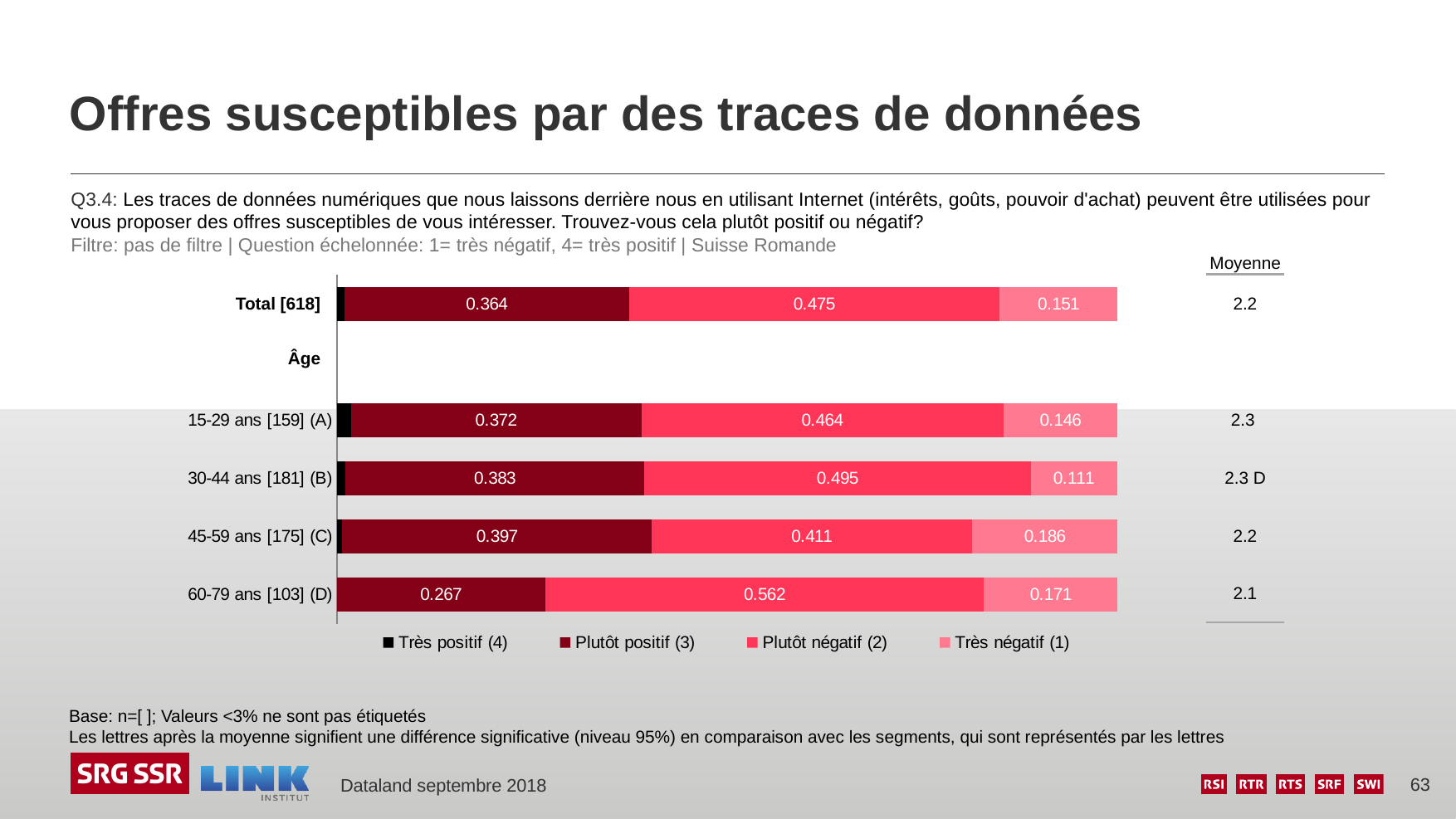
How many bars are plotted in the chart? 5 Which age group has the lowest value for Très négatif (1)? 30-44 ans [181] (B) Which age group has the highest value for Plutôt positif (3)? 45-59 ans [175] (C) How many series does the legend list? 4 Which is larger, the Plutôt positif (3) value for 15-29 ans [159] (A) or for 60-79 ans [103] (D)? 15-29 ans [159] (A) What is the value of Très négatif (1) for 45-59 ans [175] (C)? 0.186 What is the value of Plutôt positif (3) for Total [618]? 0.364 What is the Moyenne shown for 30-44 ans [181] (B)? 2.3 D Which age group has the highest value for Plutôt négatif (2)? 60-79 ans [103] (D) What kind of chart is shown on the slide? Stacked bar chart What is the difference between the Plutôt négatif (2) values for 60-79 ans [103] (D) and 45-59 ans [175] (C)? 0.151 What is the value of Plutôt négatif (2) for 60-79 ans [103] (D)? 0.562